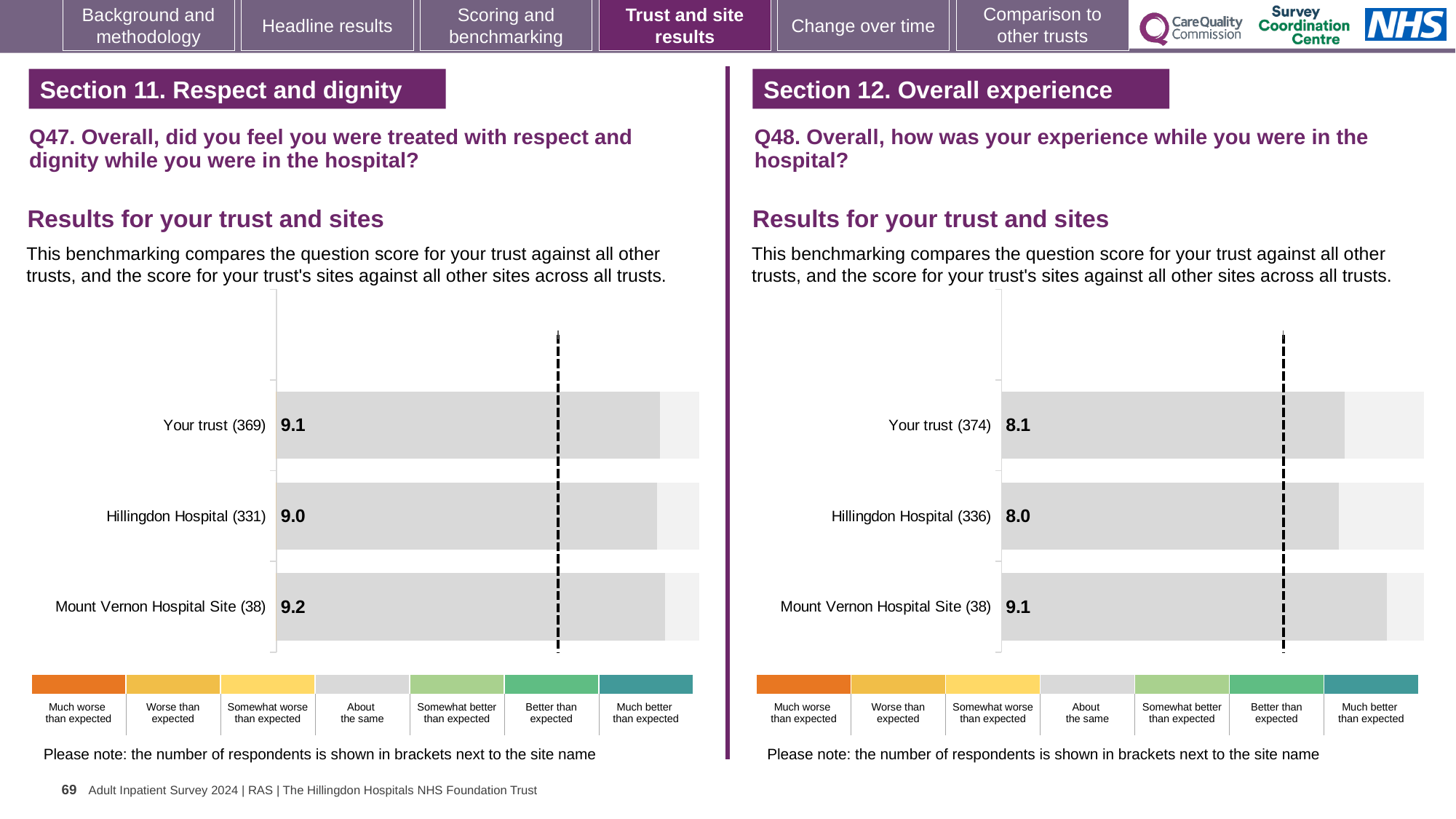
In the Q47 chart on the left, which site or trust has the highest score? Mount Vernon Hospital Site In the Q48 chart on the right, what is the score for Your trust? 8.1 In the Q47 chart on the left, what is the difference between the scores for Mount Vernon Hospital Site and Hillingdon Hospital? 0.2 In the Q47 chart on the left, what is the score for Your trust? 9.1 In the Q48 chart on the right, which site or trust has the lowest score? Hillingdon Hospital How many bars are plotted in the Q47 chart on the left? 3 In the Q48 chart on the right, what is the difference between the scores for Mount Vernon Hospital Site and Your trust? 1.0 In the Q48 chart on the right, which has the larger score, Your trust or Hillingdon Hospital? Your trust What type of chart is used for the Q48 results on the right? Bar chart In the Q47 chart on the left, what is the score for Hillingdon Hospital? 9.0 In the Q47 chart on the left, how many respondents are shown in brackets for Mount Vernon Hospital Site? 38 In the Q48 chart on the right, what is the score for Mount Vernon Hospital Site? 9.1